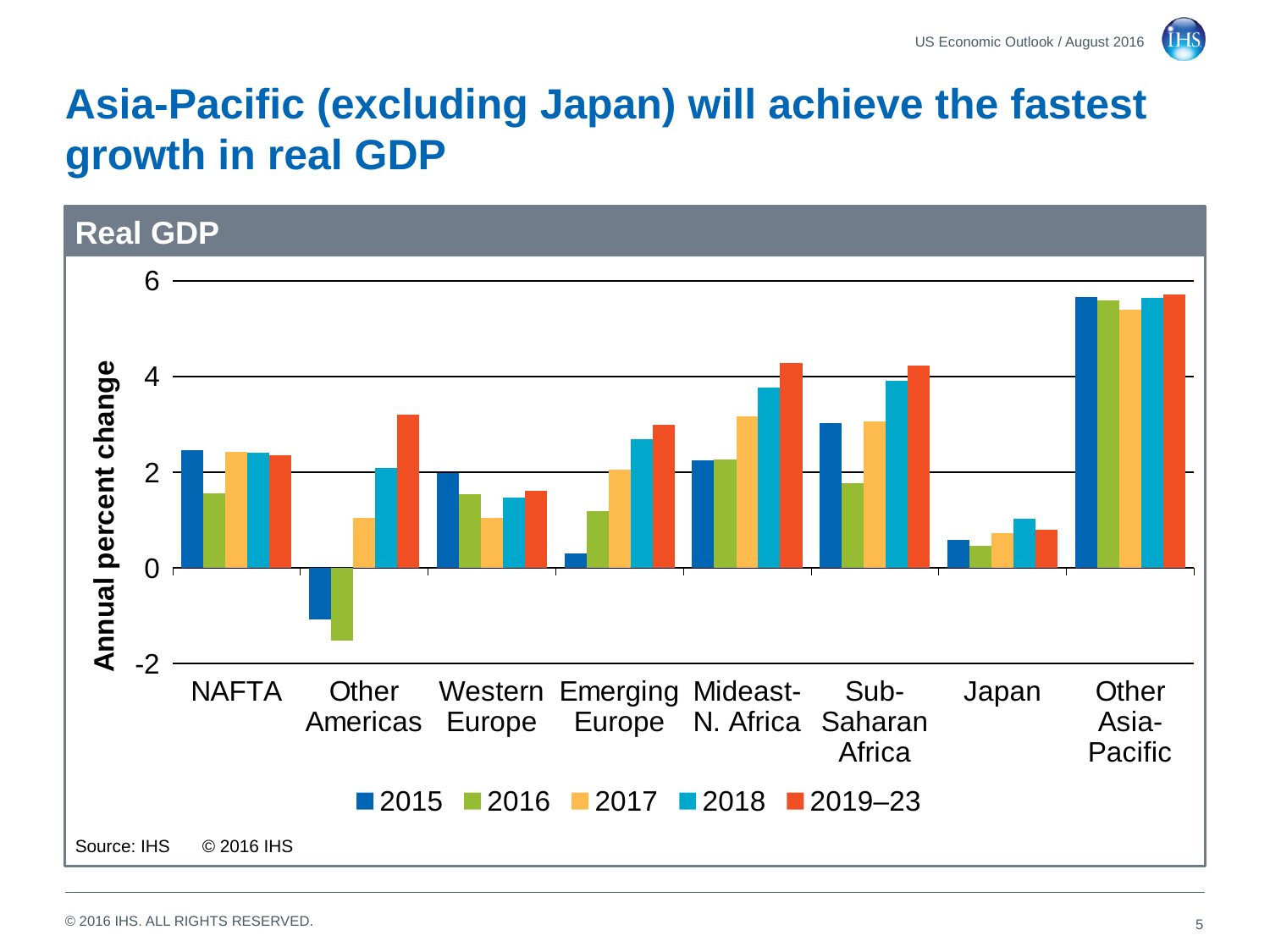
What is the label on the vertical axis of the Real GDP chart? Annual percent change Which is larger for 2019–23: Other Americas or Western Europe? Other Americas Which region has the lowest 2016 value in the Real GDP chart? Other Americas What kind of chart is shown on the slide? Bar chart Which region has the highest 2015 value in the Real GDP chart? Other Asia-Pacific Which is larger for 2018: Japan or Emerging Europe? Emerging Europe How many series does the legend of the Real GDP chart list? 5 Is the 2016 value for Other Americas greater or less than 0? less Is the 2019–23 value for Mideast-N. Africa greater or less than 4? greater Is the 2015 value for Other Asia-Pacific greater or less than 4? greater How many regions are shown along the x axis of the Real GDP chart? 8